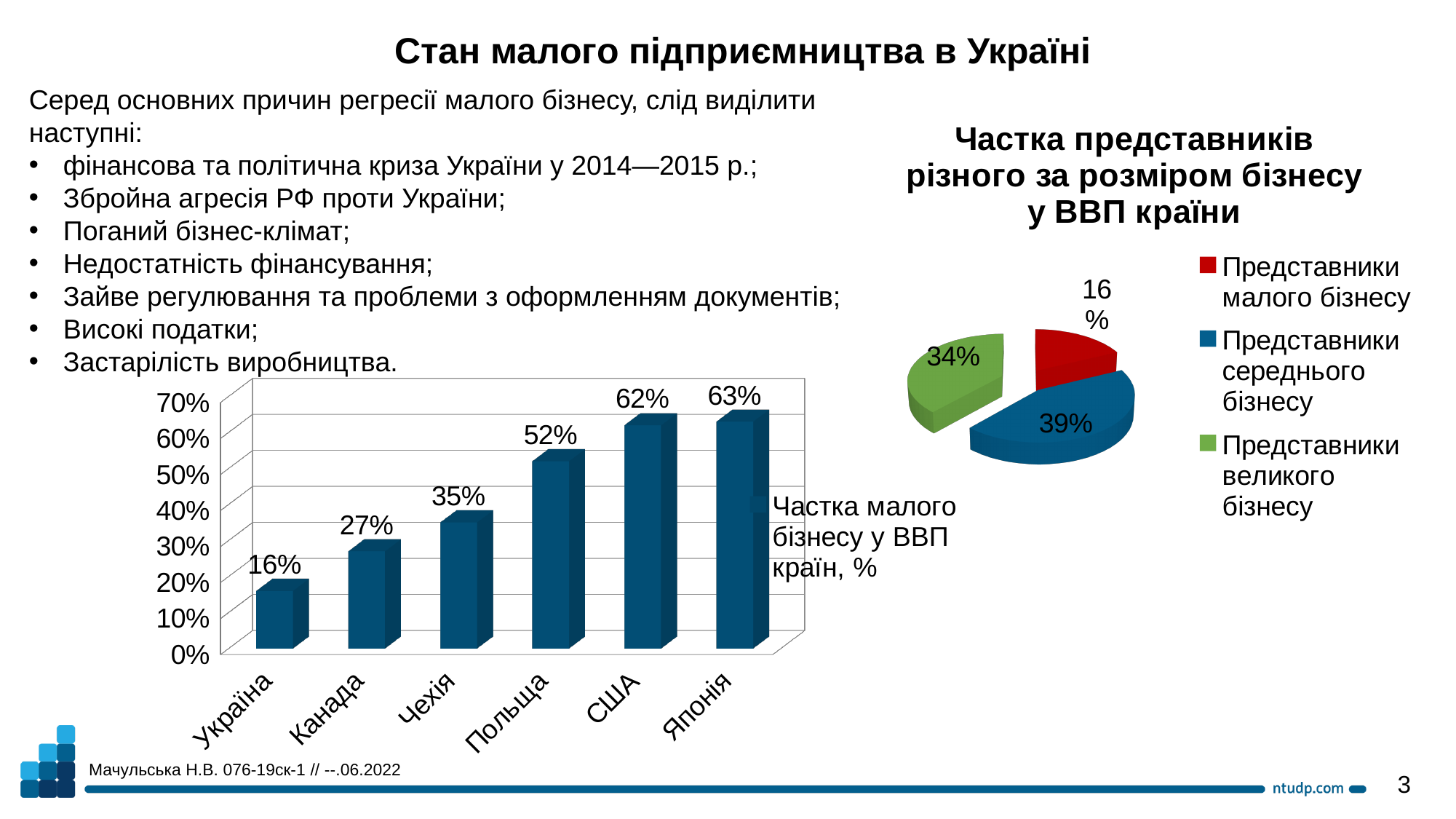
In the pie chart on the right, what share is shown for Представники середнього бізнесу? 39% In the bar chart on the left, what is the difference between the values for США and Канада? 35% In the bar chart on the left, which country has the highest value? Японія In the bar chart on the left, which country has the lowest value? Україна In the bar chart on the left, which is larger, the value for Чехія or the value for Канада? Чехія In the bar chart on the left, what is the value for Україна? 16% In the bar chart on the left, what is the value for Польща? 52% In the pie chart on the right, which category has the largest slice? Представники середнього бізнесу How many entries does the legend of the pie chart on the right list? 3 In the bar chart on the left, do the values rise or fall from Україна to Японія? rise How many countries are shown in the bar chart on the left? 6 What kind of chart is the chart on the right titled 'Частка представників різного за розміром бізнесу у ВВП країни'? pie chart